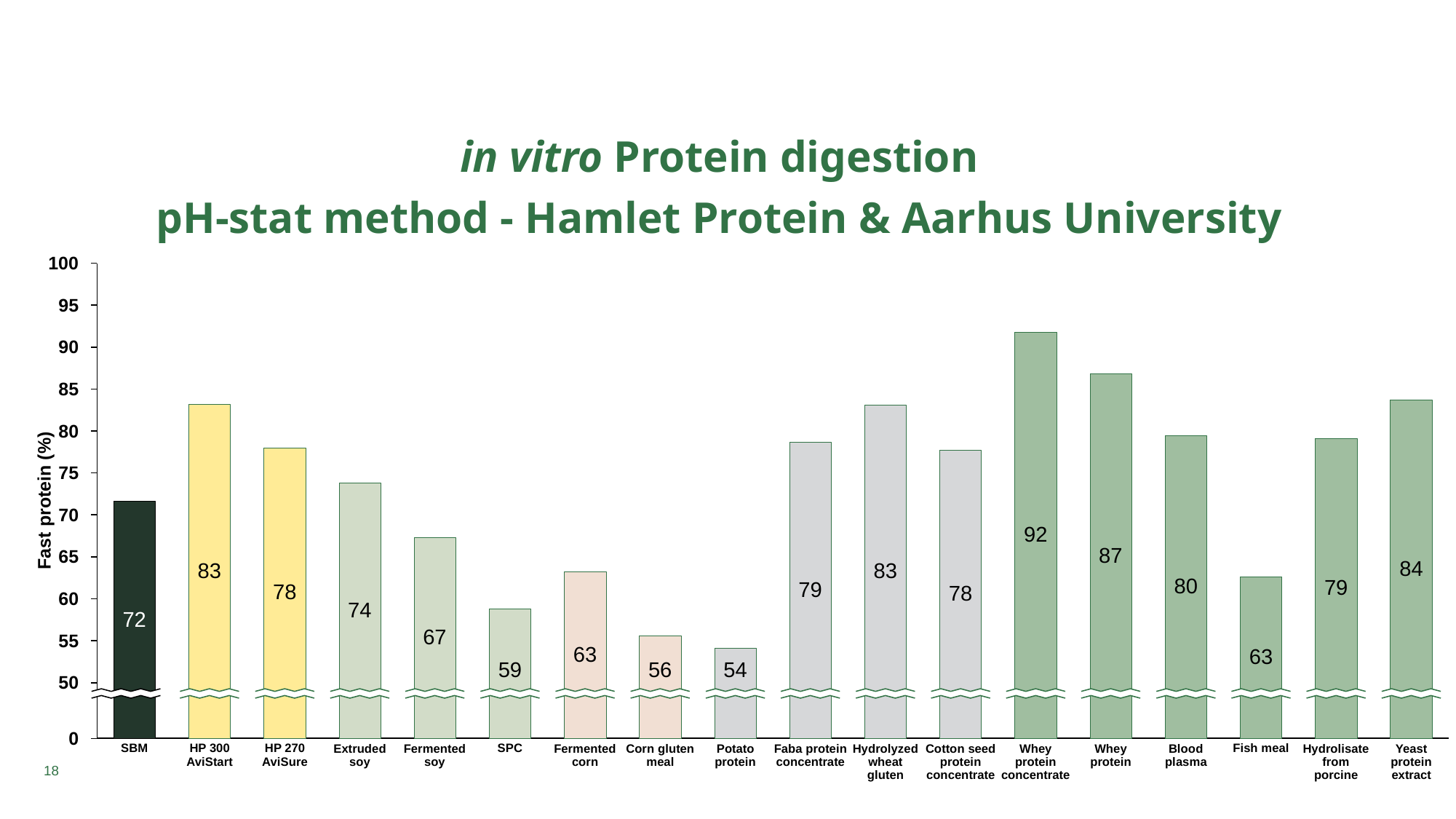
Which category has the highest fast protein (%) value? Whey protein concentrate How many categories are shown on the x axis of the chart? 18 Which has a higher fast protein (%) value, Fermented soy or Extruded soy? Extruded soy What is the fast protein (%) value for Blood plasma? 80 What kind of chart is shown on the slide? Bar chart What is the label of the y axis of the chart? Fast protein (%) Is the value for Whey protein greater or less than 85? greater What is the fast protein (%) value for SBM? 72 What is the fast protein (%) value for HP 300 AviStart? 83 What is the difference between the fast protein (%) values for Whey protein concentrate and SBM? 20 Which category has the lowest fast protein (%) value? Potato protein What is the fast protein (%) value for Potato protein? 54